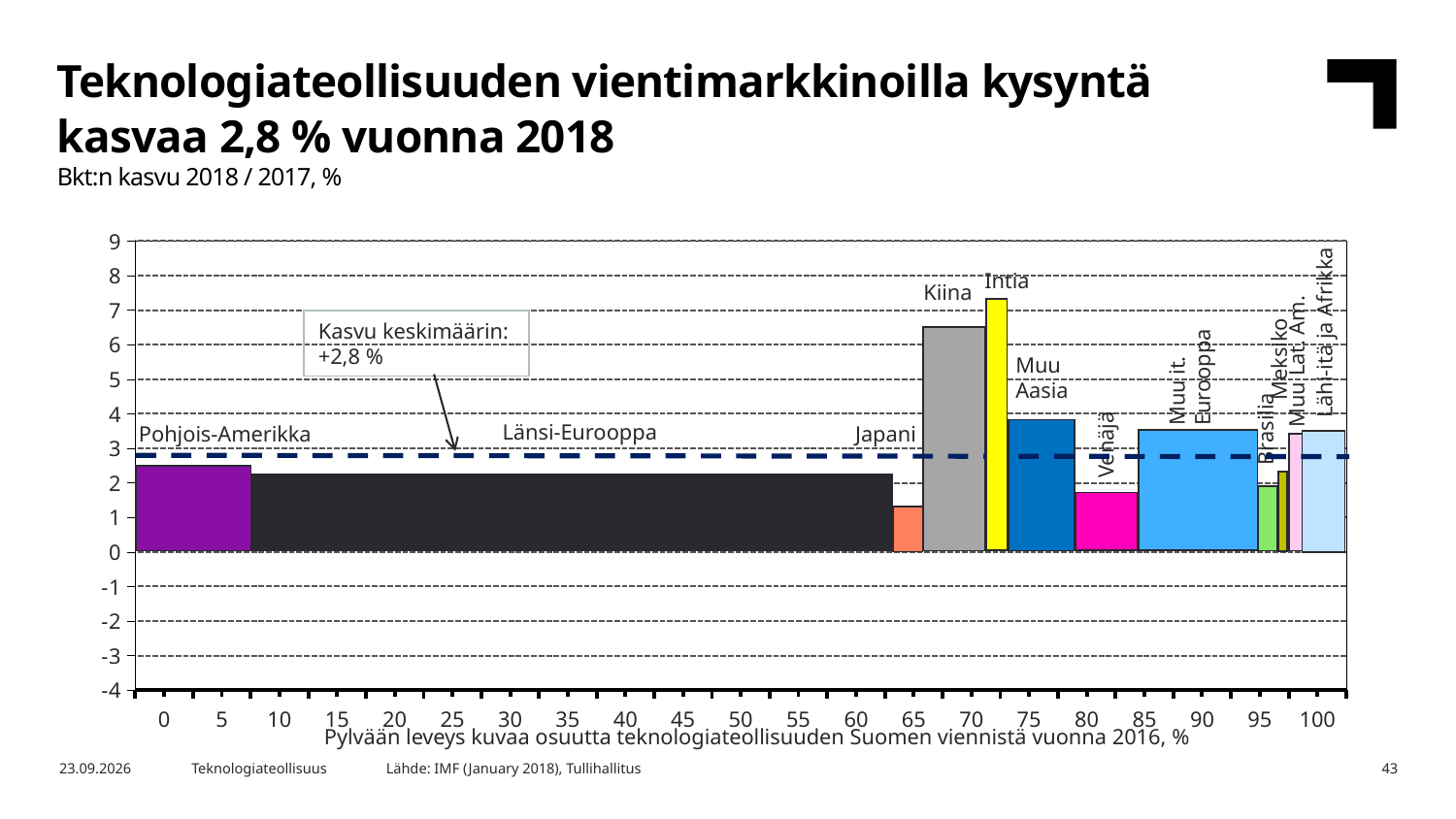
Is the value for Intia greater or less than 7? greater Is the value for Kiina greater or less than 6? greater Is the value for Venäjä greater or less than 2? less Which has the larger value, Pohjois-Amerikka or Länsi-Eurooppa? Pohjois-Amerikka Which region has the lowest GDP growth in the chart? Japani What is the average growth (Kasvu keskimäärin) shown on the chart? +2,8 % How many regions (bars) are shown in the chart? 12 Which region has the highest GDP growth in the chart? Intia What kind of chart is shown on the slide? bar chart Which has the larger value, Kiina or Intia? Intia